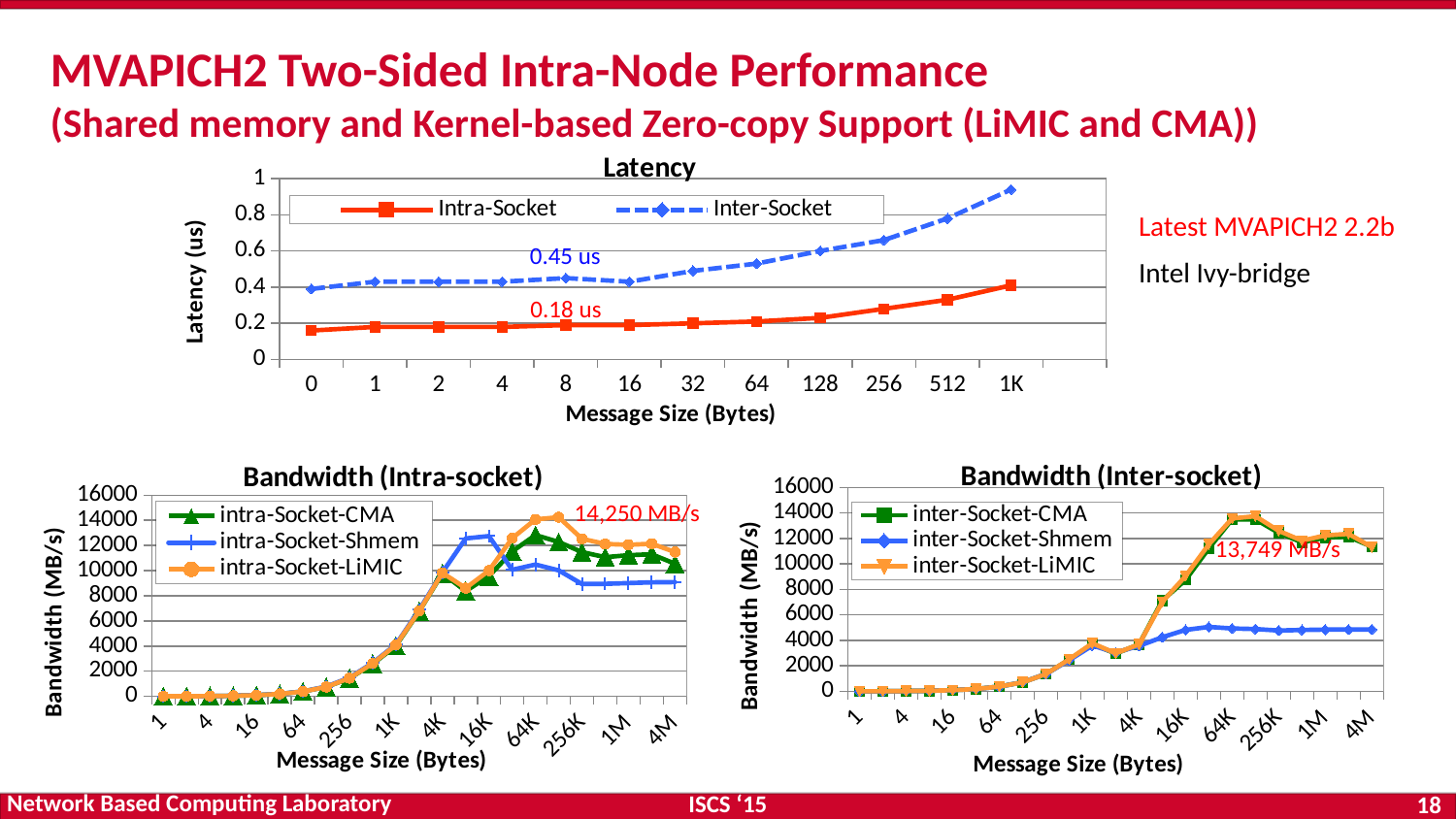
In the Latency chart, what latency value is annotated on the Inter-Socket line? 0.45 us What kind of chart is the Latency chart? line chart In the Latency chart, is the Inter-Socket latency at 1K greater or less than 0.8? greater How many series does the legend of the Latency chart list? 2 In the Latency chart, does the Inter-Socket latency rise or fall as message size increases from 128 to 1K? rise In the Latency chart, which series has the higher latency at message size 1K? Inter-Socket In the Latency chart, is the Intra-Socket latency at 1K greater or less than 0.6? less In the Bandwidth (Inter-socket) chart, which series has the lowest bandwidth at message size 4M? inter-Socket-Shmem How many series does the legend of the Bandwidth (Intra-socket) chart list? 3 What peak bandwidth value is annotated on the Bandwidth (Intra-socket) chart? 14,250 MB/s In the Latency chart, what latency value is annotated on the Intra-Socket line? 0.18 us How many message sizes are shown on the x axis of the Latency chart? 12